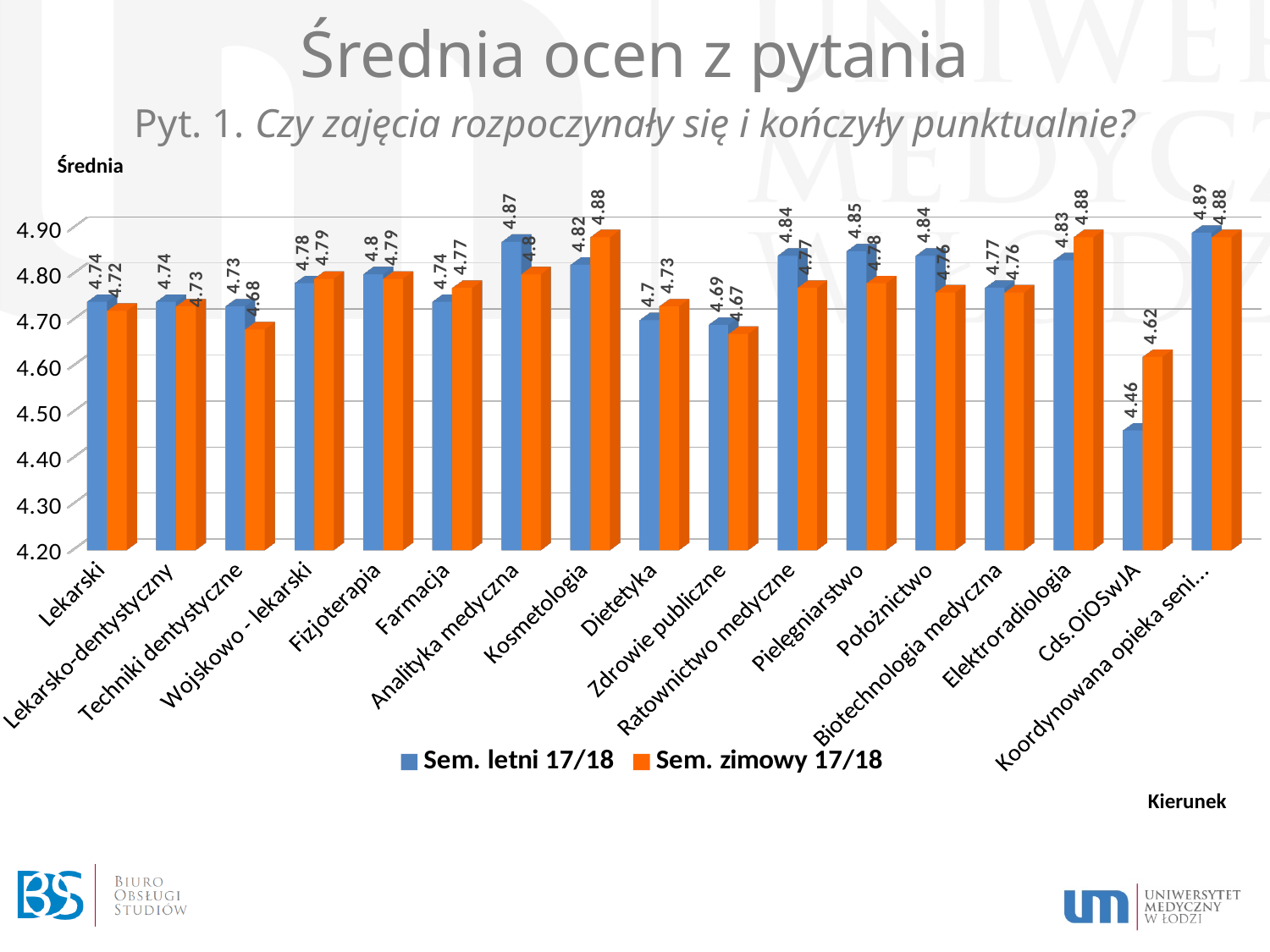
How many series does the legend list? 2 What is the value for Analityka medyczna in the Sem. letni 17/18 series? 4.87 Which category has the lowest value in the Sem. zimowy 17/18 series? Cds.OiOSwJA What is the value for Techniki dentystyczne in the Sem. zimowy 17/18 series? 4.68 Which category has the lowest value in the Sem. letni 17/18 series? Cds.OiOSwJA For Pielęgniarstwo, which series has the larger value: Sem. letni 17/18 or Sem. zimowy 17/18? Sem. letni 17/18 What is the difference between the Sem. zimowy 17/18 and Sem. letni 17/18 values for Cds.OiOSwJA? 0.16 What is the value for Cds.OiOSwJA in the Sem. letni 17/18 series? 4.46 How many categories are shown on the x axis? 17 What is the value for Kosmetologia in the Sem. zimowy 17/18 series? 4.88 Is the Sem. letni 17/18 value for Cds.OiOSwJA greater or less than 4.50? less What kind of chart is shown on the slide? bar chart